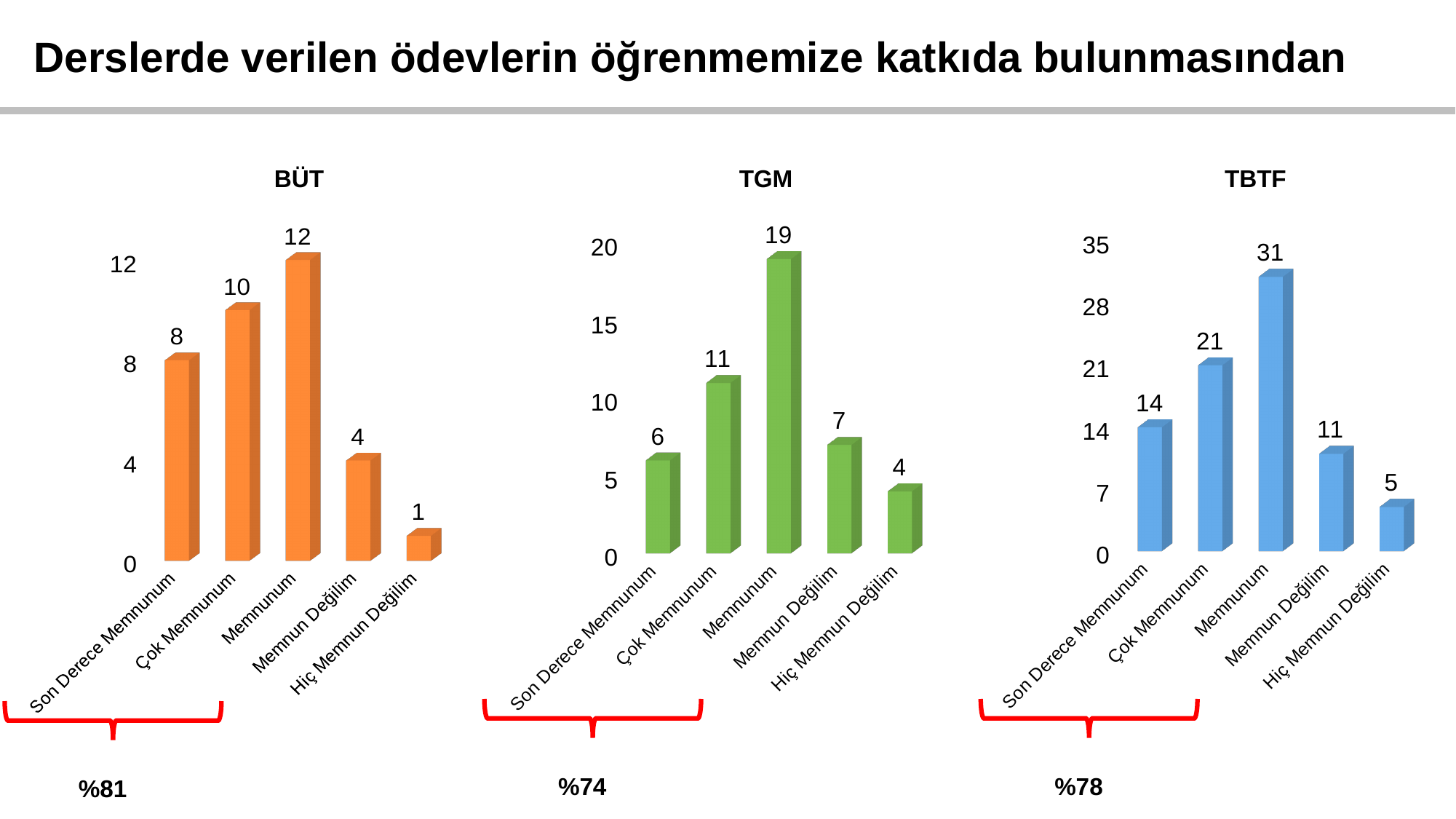
In the TBTF chart, which is larger: the value for Son Derece Memnunum or the value for Memnun Değilim? Son Derece Memnunum In the TBTF chart, which category has the highest value? Memnunum What type of chart is the TGM chart? bar chart In the TGM chart, what is the value for Çok Memnunum? 11 In the BÜT chart, what is the value for Memnunum? 12 In the BÜT chart, which category has the lowest value? Hiç Memnun Değilim In the TBTF chart, what is the difference between the values for Çok Memnunum and Son Derece Memnunum? 7 In the TGM chart, what is the difference between the values for Memnunum and Memnun Değilim? 12 In the TGM chart, is the value for Memnunum greater or less than 15? greater What colour are the bars in the TBTF chart? blue In the TBTF chart, what is the value for Hiç Memnun Değilim? 5 How many categories are shown in the BÜT chart? 5